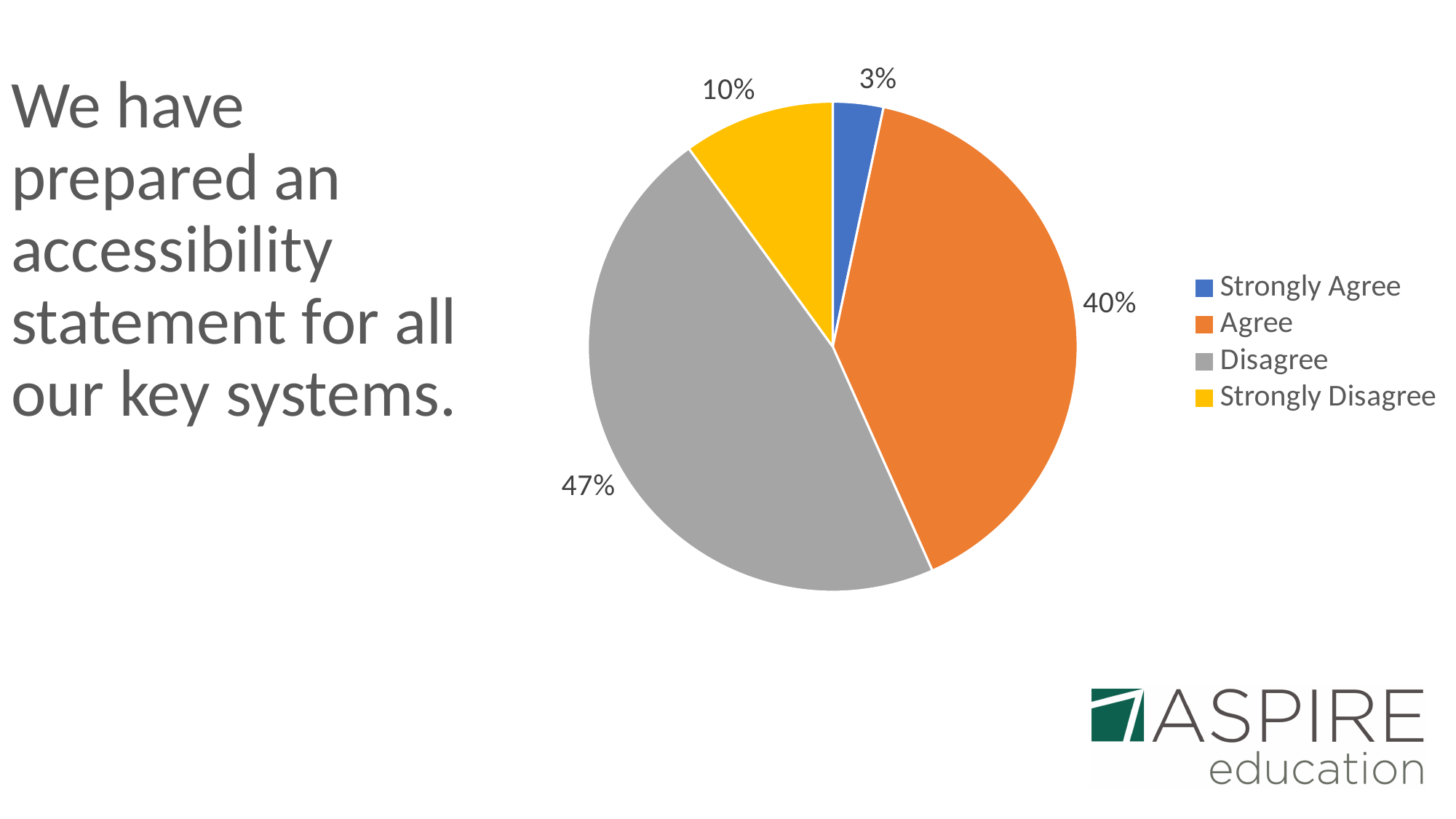
Which is larger, the share for Strongly Disagree or the share for Strongly Agree? Strongly Disagree What percentage of respondents chose Disagree? 47% What percentage of respondents chose Strongly Agree? 3% What percentage of respondents chose Agree? 40% How many categories does the pie chart show? 4 Which colour represents Disagree in the pie chart? Grey What percentage of respondents chose Strongly Disagree? 10% What is the combined percentage of Strongly Agree and Agree? 43% Which response category has the smallest share of the pie? Strongly Agree What type of chart is shown on the slide? Pie chart What is the difference in percentage points between Disagree and Agree? 7 Which response category has the largest share of the pie? Disagree